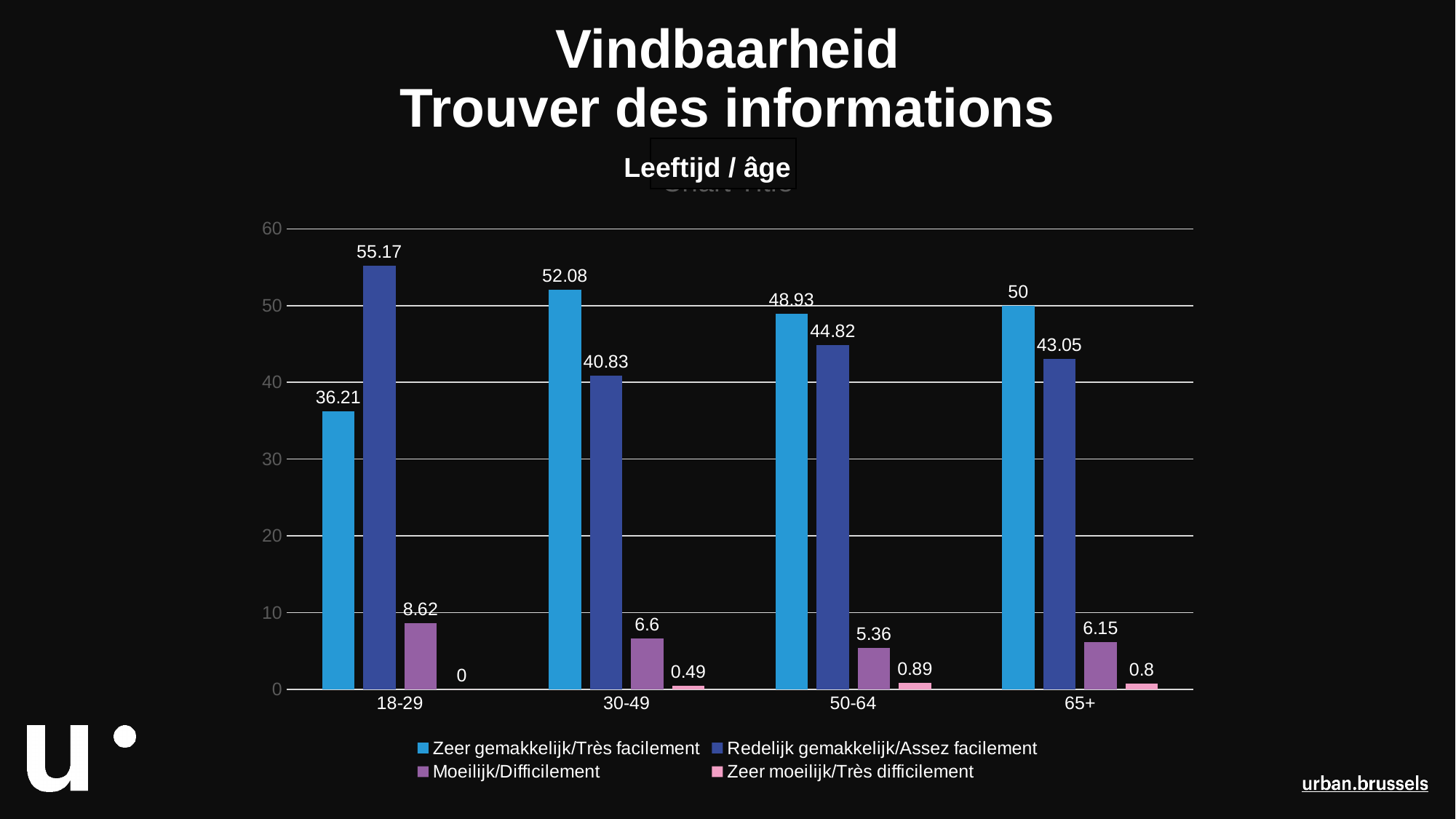
Which is larger in the 50-64 age group: Zeer gemakkelijk/Très facilement or Redelijk gemakkelijk/Assez facilement? Zeer gemakkelijk/Très facilement What is the value for Zeer moeilijk/Très difficilement in the 50-64 age group? 0.89 Does the value for Redelijk gemakkelijk/Assez facilement rise or fall from 18-29 to 30-49? Fall What kind of chart is shown on the slide? Bar chart How many series does the legend list? 4 What is the value for Moeilijk/Difficilement in the 30-49 age group? 6.6 What is the value for Redelijk gemakkelijk/Assez facilement in the 65+ age group? 43.05 How many age groups are shown on the x axis? 4 What is the difference between the Zeer gemakkelijk/Très facilement and Redelijk gemakkelijk/Assez facilement values in the 30-49 age group? 11.25 Which age group has the highest value for Redelijk gemakkelijk/Assez facilement? 18-29 What is the value for Zeer gemakkelijk/Très facilement in the 18-29 age group? 36.21 Which age group has the lowest value for Zeer gemakkelijk/Très facilement? 18-29